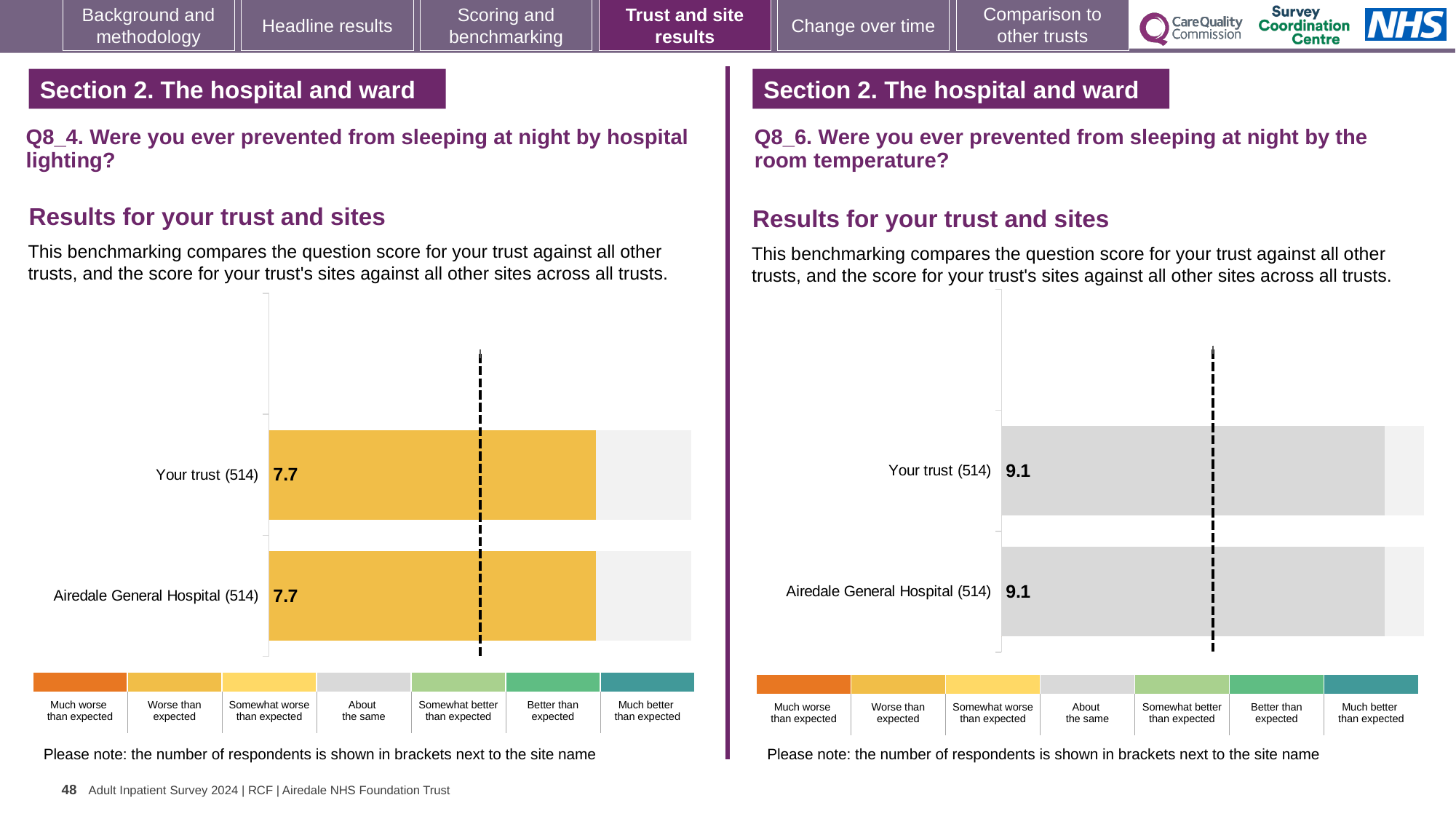
On the Q8_4 hospital lighting chart, what is the score for Your trust (514)? 7.7 What kind of chart is used on the left-hand Q8_4 chart? Bar chart On the Q8_6 room temperature chart, what is the score for Airedale General Hospital (514)? 9.1 On the Q8_6 room temperature chart, what is the score for Your trust (514)? 9.1 According to the colour key, which benchmark category do the bars on the Q8_4 hospital lighting chart fall into? Worse than expected How many respondents are shown in brackets for Your trust on the Q8_6 room temperature chart? 514 How many bars are plotted on the Q8_6 room temperature chart? 2 According to the colour key, which benchmark category do the bars on the Q8_6 room temperature chart fall into? About the same On the Q8_6 room temperature chart, what is the difference between the score for Your trust and the score for Airedale General Hospital? 0.0 On the Q8_4 hospital lighting chart, what is the difference between the score for Your trust and the score for Airedale General Hospital? 0.0 On the Q8_4 hospital lighting chart, what is the score for Airedale General Hospital (514)? 7.7 How many bars are plotted on the Q8_4 hospital lighting chart? 2